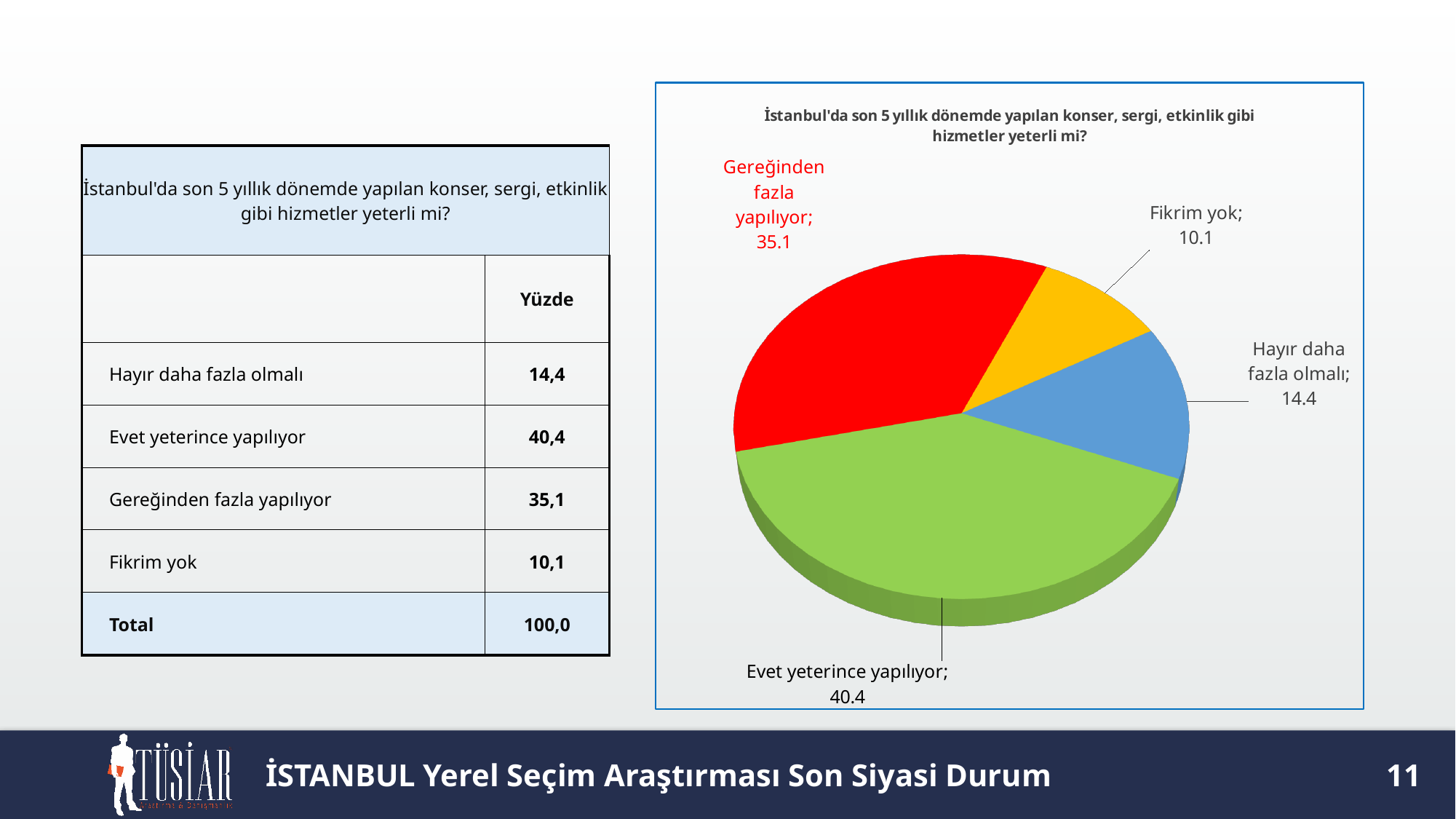
What is the value for "Evet yeterince yapılıyor" in the pie chart? 40.4 What is the value for "Hayır daha fazla olmalı" in the pie chart? 14.4 What is the title of the pie chart? İstanbul'da son 5 yıllık dönemde yapılan konser, sergi, etkinlik gibi hizmetler yeterli mi? What type of chart is shown on the slide? pie chart Which is larger in the pie chart: "Hayır daha fazla olmalı" or "Fikrim yok"? Hayır daha fazla olmalı What colour is the slice for "Evet yeterince yapılıyor" in the pie chart? green How many slices does the pie chart have? 4 Which category has the smallest slice in the pie chart? Fikrim yok Which category has the largest slice in the pie chart? Evet yeterince yapılıyor What is the value for "Gereğinden fazla yapılıyor" in the pie chart? 35.1 What is the difference between the values for "Evet yeterince yapılıyor" and "Gereğinden fazla yapılıyor" in the pie chart? 5.3 What is the value for "Fikrim yok" in the pie chart? 10.1